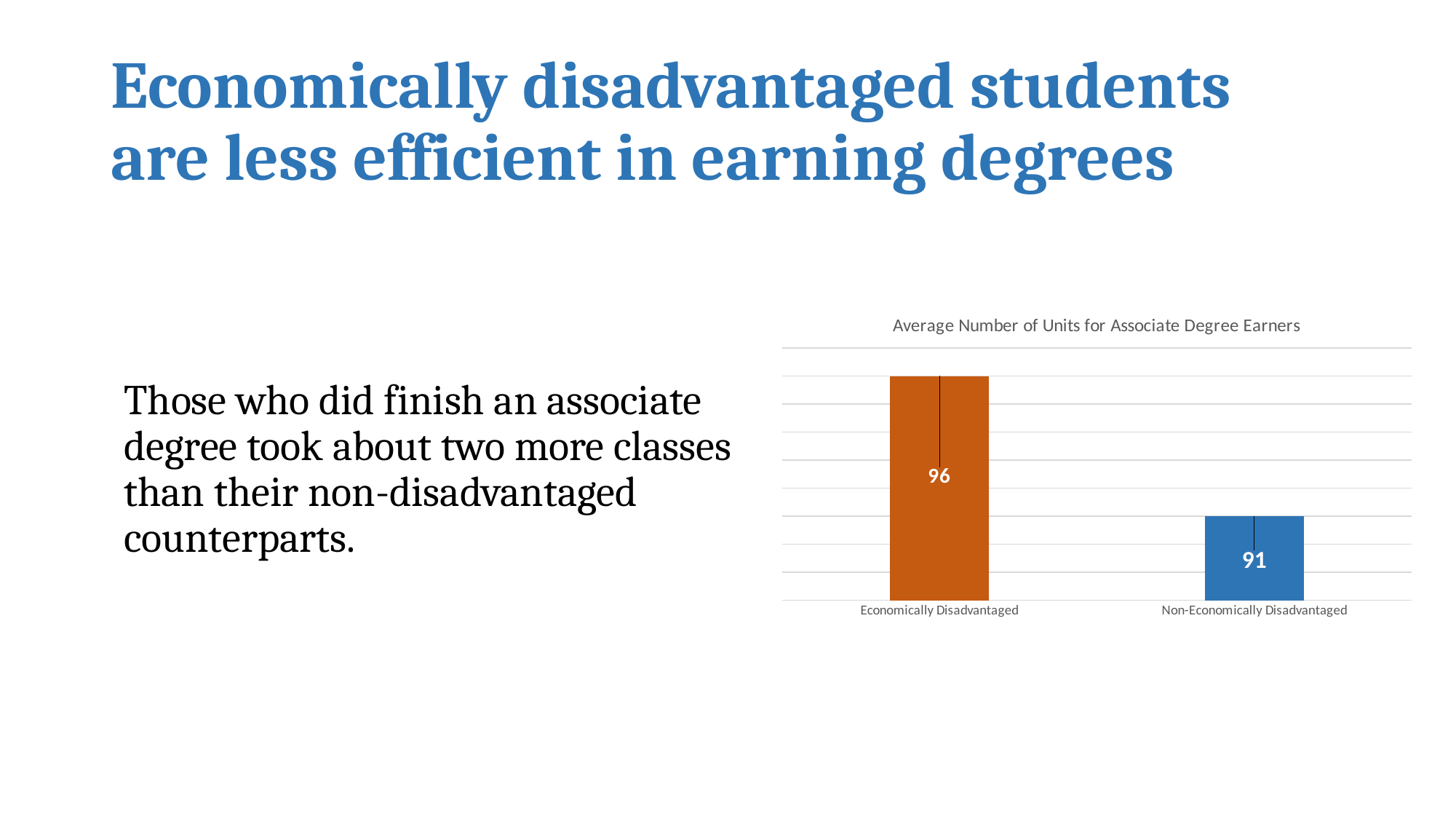
What colour is the bar for Economically Disadvantaged? orange What is the average number of units for Economically Disadvantaged associate degree earners? 96 Is the value for Economically Disadvantaged larger or smaller than the value for Non-Economically Disadvantaged? larger Which category has the higher average number of units? Economically Disadvantaged What is the difference in average number of units between Economically Disadvantaged and Non-Economically Disadvantaged students? 5 What kind of chart is shown on the slide? bar chart How many categories are shown in the chart? 2 What is the title of the chart? Average Number of Units for Associate Degree Earners What is the average number of units for Non-Economically Disadvantaged associate degree earners? 91 Which category has the lower average number of units? Non-Economically Disadvantaged